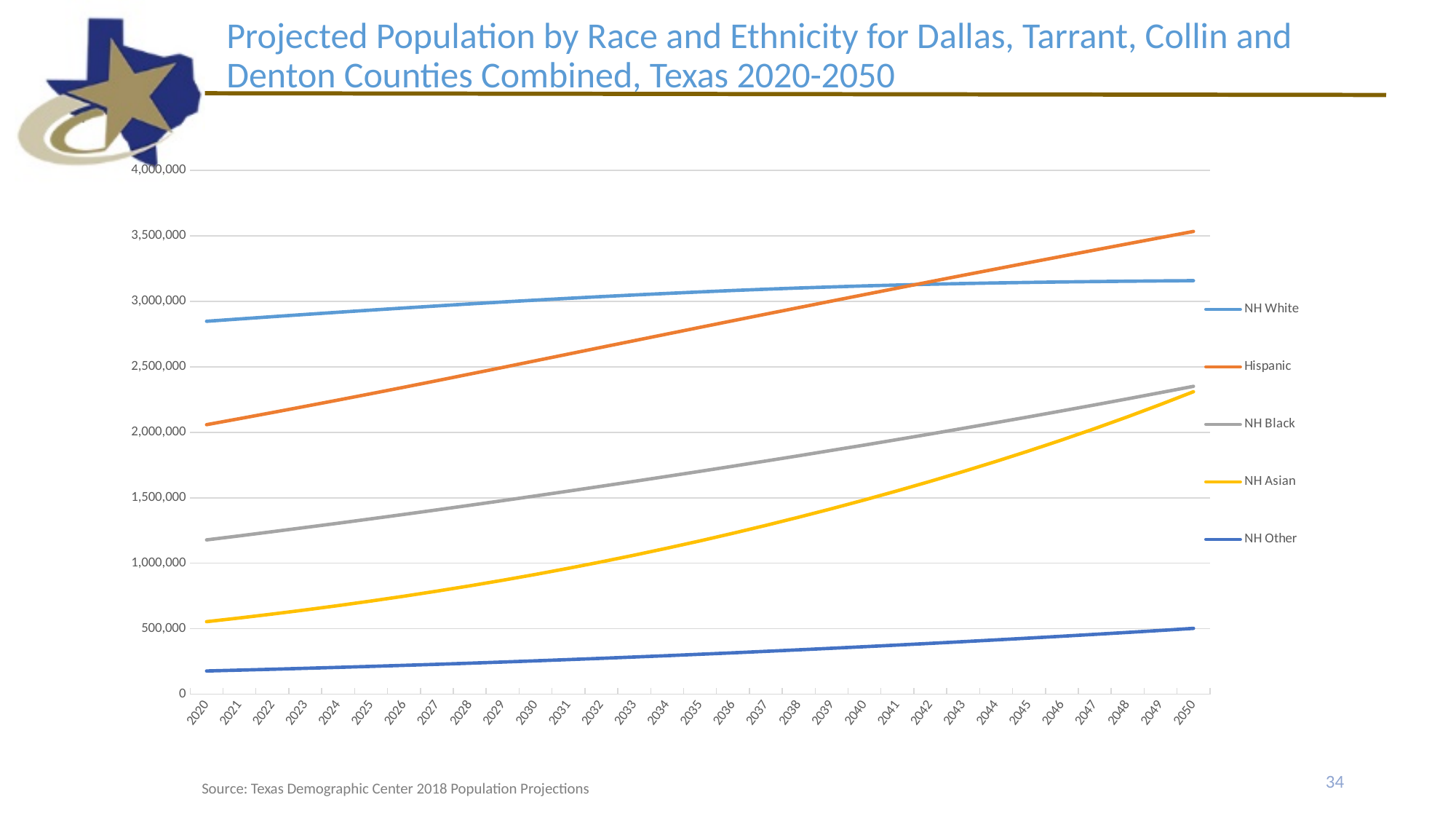
What is the source cited at the bottom of the slide? Texas Demographic Center 2018 Population Projections Which series has the highest value in 2050? Hispanic Is the value for NH Asian in 2050 greater or less than 2,000,000? greater Which series has the lowest value in 2050? NH Other Which series has the highest value in 2020? NH White In 2020, which is larger, NH Black or NH Asian? NH Black How many years are shown along the x axis? 31 How many series does the legend list? 5 In 2050, which is larger, Hispanic or NH White? Hispanic Does the Hispanic series rise or fall from 2020 to 2050? rise Is the value for NH White in 2020 greater or less than 3,000,000? less What kind of chart is shown on the slide? line chart